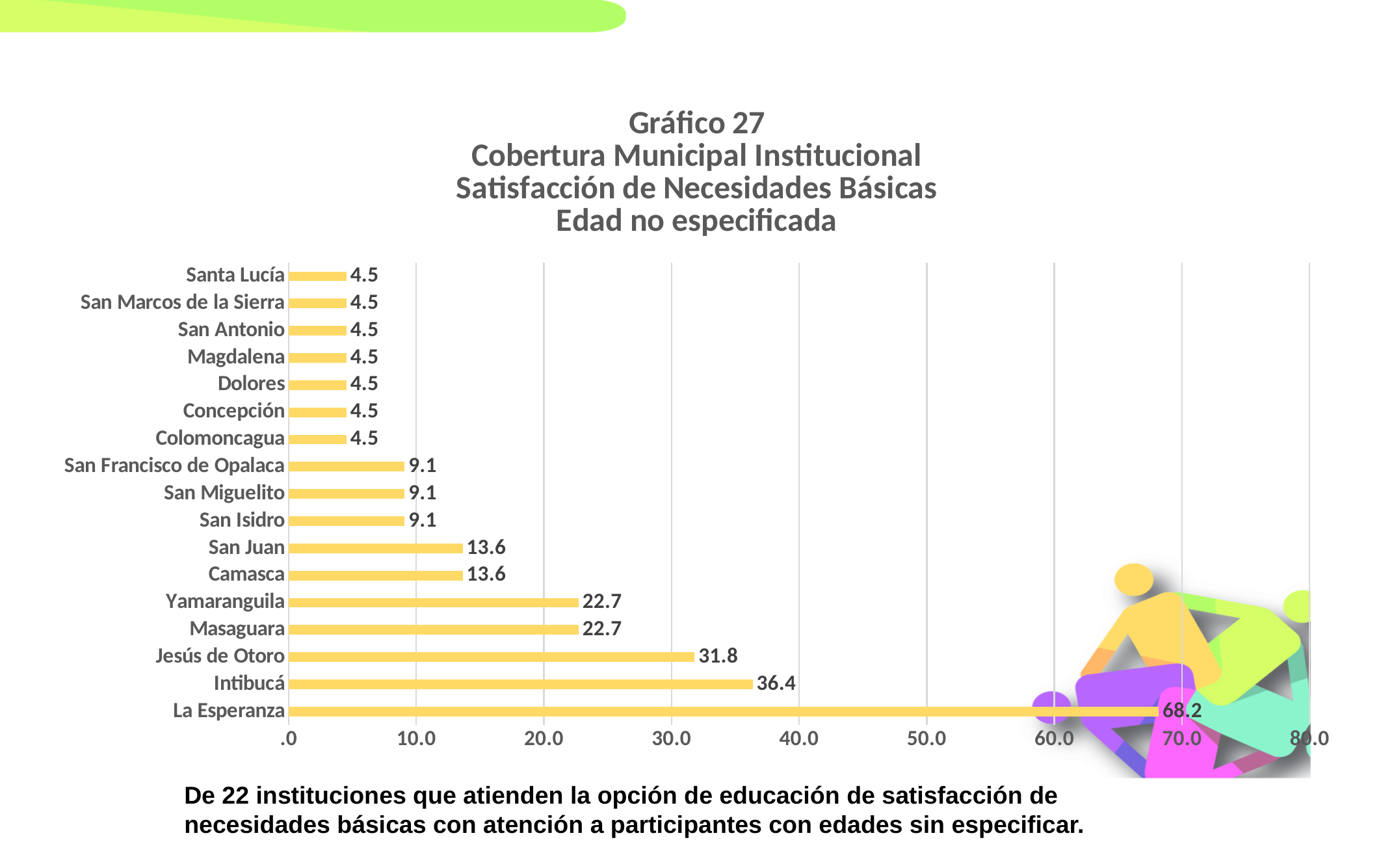
What is the value for La Esperanza? 68.2 What is the value for Jesús de Otoro? 31.8 Which is larger, the value for Camasca or the value for San Isidro? Camasca Which municipality has the highest value? La Esperanza What is the difference between the values for Jesús de Otoro and Masaguara? 9.1 What is the value for Yamaranguila? 22.7 What kind of chart is shown on the slide? Bar chart What is the value for San Juan? 13.6 What is the difference between the values for La Esperanza and Intibucá? 31.8 How many municipalities are shown in the chart? 17 Is the value for Intibucá greater or less than 40.0? less What is the value for Intibucá? 36.4